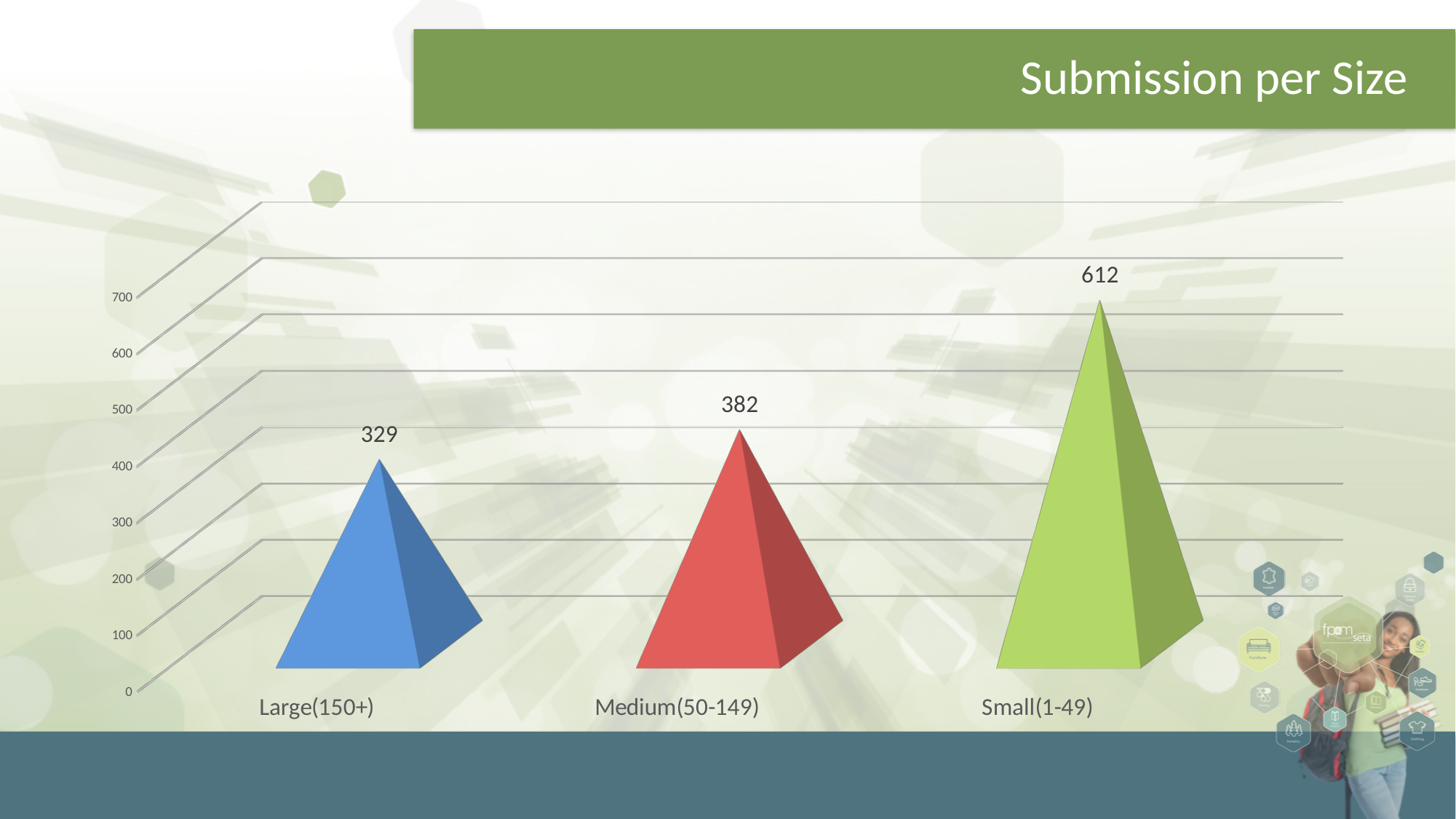
What is the value for Large(150+)? 329 What is the value for Medium(50-149)? 382 What is the difference between the values for Small(1-49) and Large(150+)? 283 What is the title of the slide? Submission per Size Which category has the lowest value? Large(150+) Is the value for Small(1-49) greater or less than 500? greater Which category has the highest value? Small(1-49) What is the value for Small(1-49)? 612 Which is larger, the value for Medium(50-149) or the value for Small(1-49)? Small(1-49) How many categories are shown on the chart? 3 What kind of chart is shown on the slide? bar chart What is the difference between the values for Medium(50-149) and Large(150+)? 53